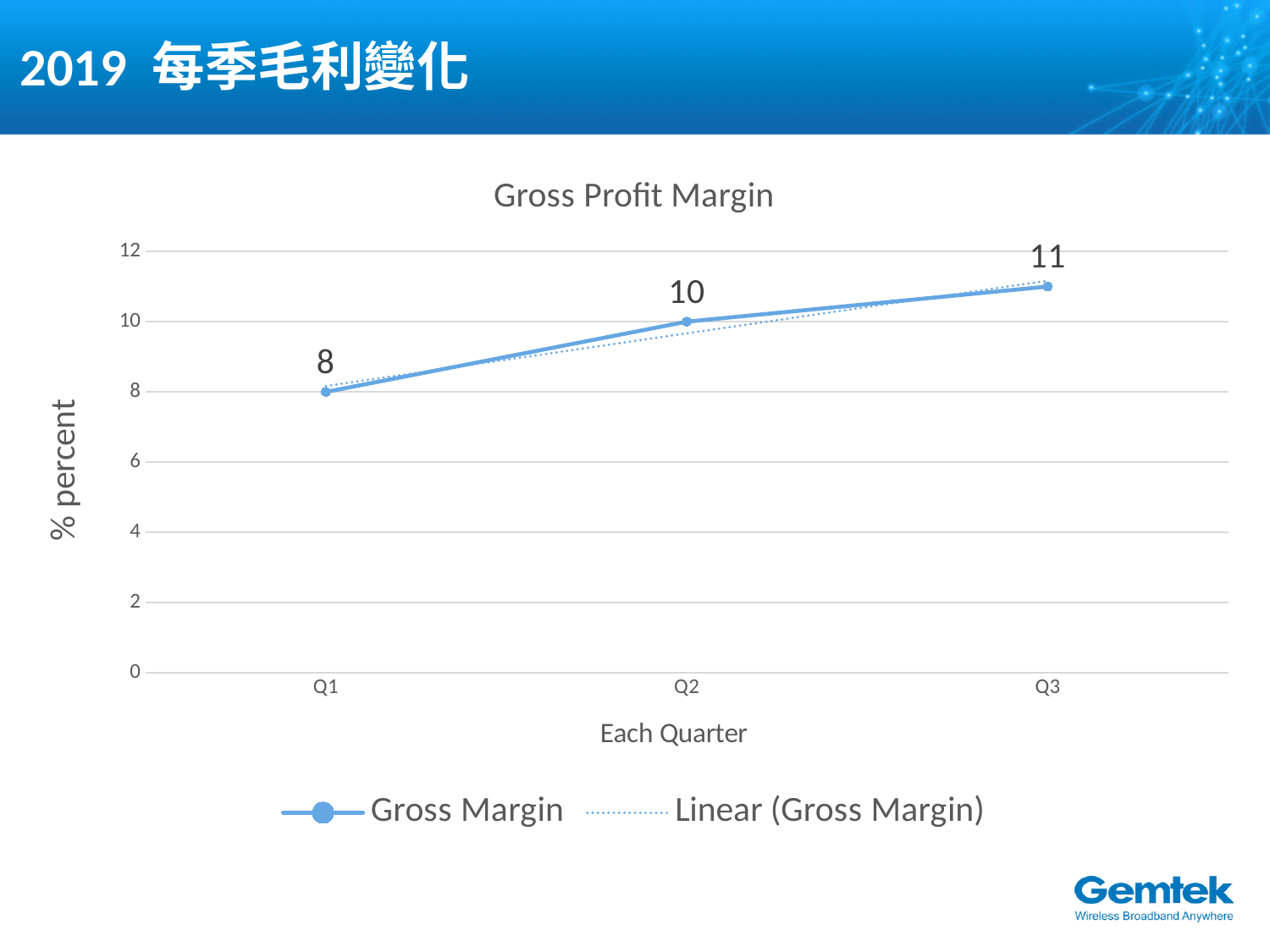
What is the Gross Margin value for Q3? 11 What is the Gross Margin value for Q2? 10 How many entries does the legend list? 2 What kind of chart is shown? Line chart What is the difference between the Gross Margin in Q3 and Q1? 3 Which is larger, the Gross Margin in Q2 or in Q1? Q2 Which quarter has the highest Gross Margin? Q3 What is the Gross Margin value for Q1? 8 How many quarters are plotted on the x axis? 3 What is the title of the chart? Gross Profit Margin Which quarter has the lowest Gross Margin? Q1 Does the Gross Margin rise or fall from Q1 to Q3? Rise